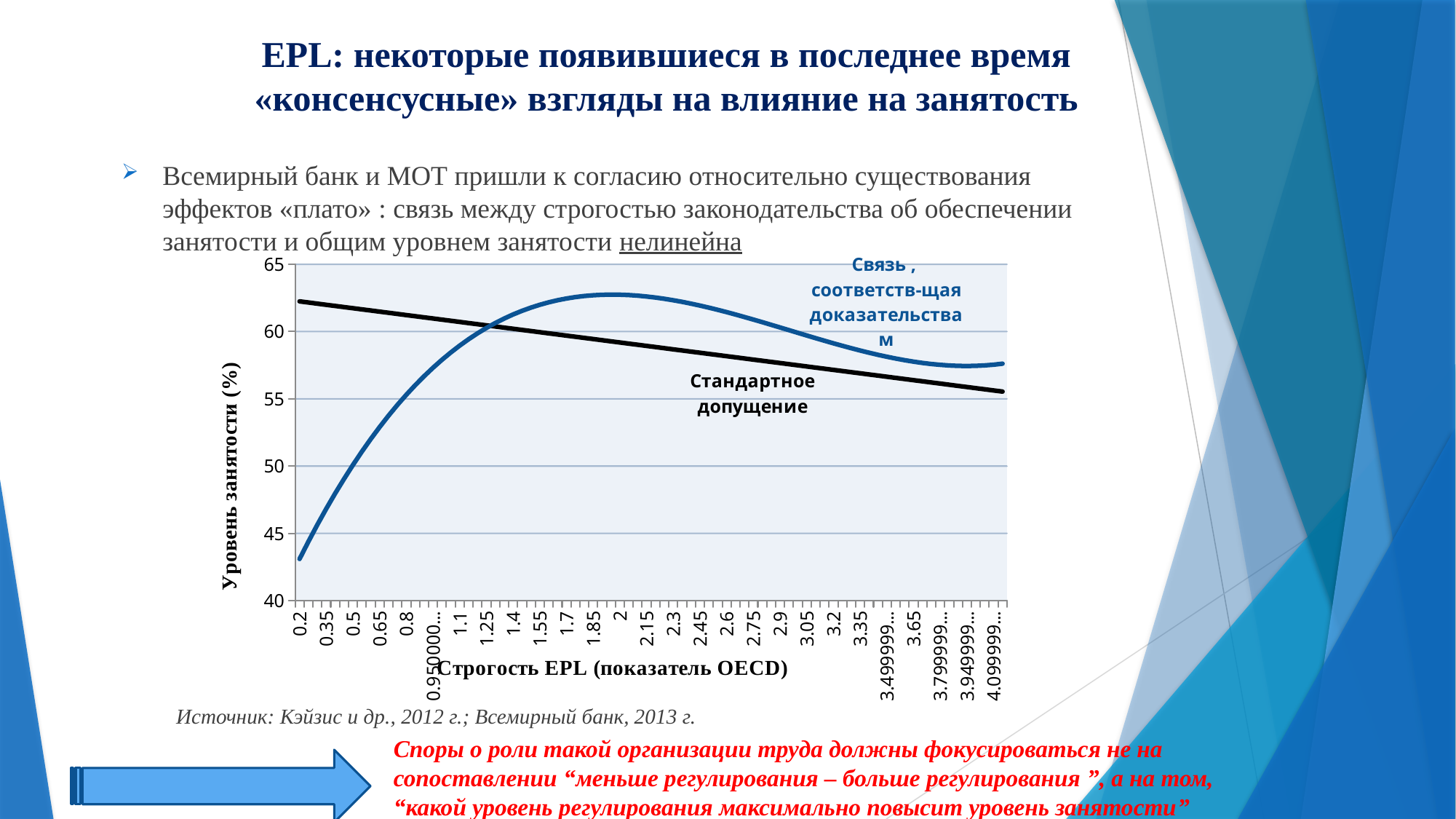
What is the title of the vertical axis of the chart? Уровень занятости (%) Is the value of the «Стандартное допущение» line at x = 0.2 greater or less than 60? greater What kind of chart is shown on the slide? line chart How many lines (series) are plotted on the chart? 2 What is the title of the horizontal axis of the chart? Строгость EPL (показатель OECD) Is the value of the blue curve at x = 0.2 greater or less than 45? less Is the value of the «Стандартное допущение» line at the right end of the x axis greater or less than 60? less Does the blue curve labelled «Связь, соответств-щая доказательствам» rise or fall between x = 0.2 and x = 2? rise At x = 0.2, which line is higher: «Стандартное допущение» or the blue curve «Связь, соответств-щая доказательствам»? Стандартное допущение Does the line labelled «Стандартное допущение» rise or fall as EPL strictness increases along the x axis? fall At x = 2, which line is higher: «Стандартное допущение» or the blue curve «Связь, соответств-щая доказательствам»? Связь, соответств-щая доказательствам